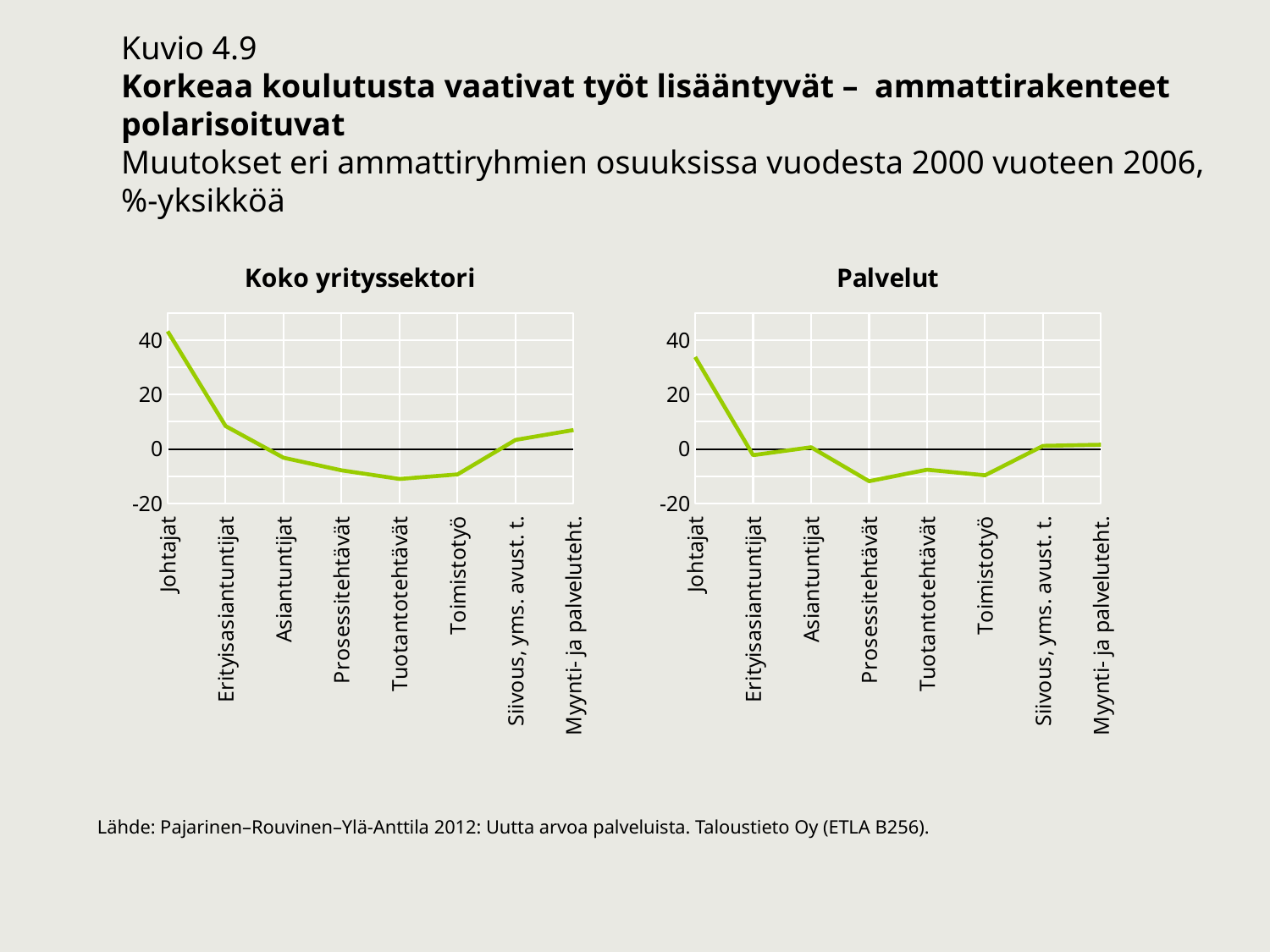
How many categories are plotted on the x axis of the "Palvelut" chart? 8 In the "Koko yrityssektori" chart, is the value for Johtajat greater or less than 40? greater In the "Koko yrityssektori" chart, which category has the lowest value? Tuotantotehtävät In the "Koko yrityssektori" chart, which is larger, the value for Erityisasiantuntijat or the value for Asiantuntijat? Erityisasiantuntijat In the "Palvelut" chart, which category has the lowest value? Prosessitehtävät What are the titles of the two charts on the slide? Koko yrityssektori and Palvelut In the "Palvelut" chart, which is larger, the value for Tuotantotehtävät or the value for Prosessitehtävät? Tuotantotehtävät In the "Palvelut" chart, which category has the highest value? Johtajat In the "Koko yrityssektori" chart, is the value for Tuotantotehtävät greater or less than 0? less In the "Palvelut" chart, is the value for Johtajat greater or less than 40? less In the "Koko yrityssektori" chart, which category has the highest value? Johtajat What kind of chart is the "Koko yrityssektori" chart? line chart